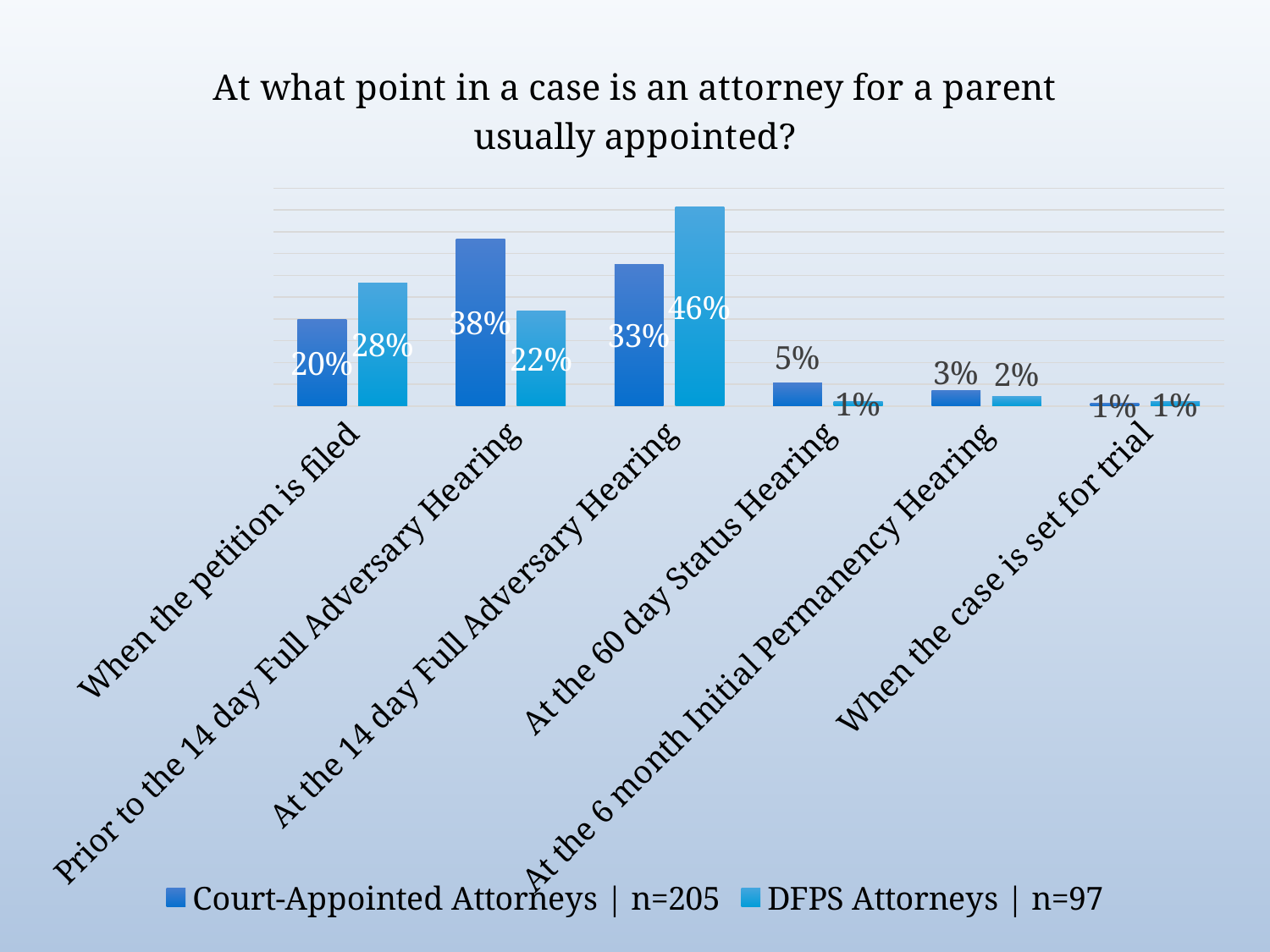
What is the difference between the DFPS Attorneys and Court-Appointed Attorneys values for 'When the petition is filed'? 8% Which category has the highest value for DFPS Attorneys? At the 14 day Full Adversary Hearing What percentage of DFPS Attorneys said an attorney is usually appointed at the 14 day Full Adversary Hearing? 46% What percentage of Court-Appointed Attorneys said an attorney for a parent is usually appointed when the petition is filed? 20% How many categories are shown on the x axis? 6 What percentage of Court-Appointed Attorneys said an attorney is usually appointed prior to the 14 day Full Adversary Hearing? 38% What percentage of DFPS Attorneys said an attorney is usually appointed at the 60 day Status Hearing? 1% How many series does the legend list? 2 What is the sample size (n) for the Court-Appointed Attorneys series shown in the legend? 205 Which category has the highest value for Court-Appointed Attorneys? Prior to the 14 day Full Adversary Hearing For 'Prior to the 14 day Full Adversary Hearing', which series has the larger value? Court-Appointed Attorneys What kind of chart is shown on the slide? Bar chart